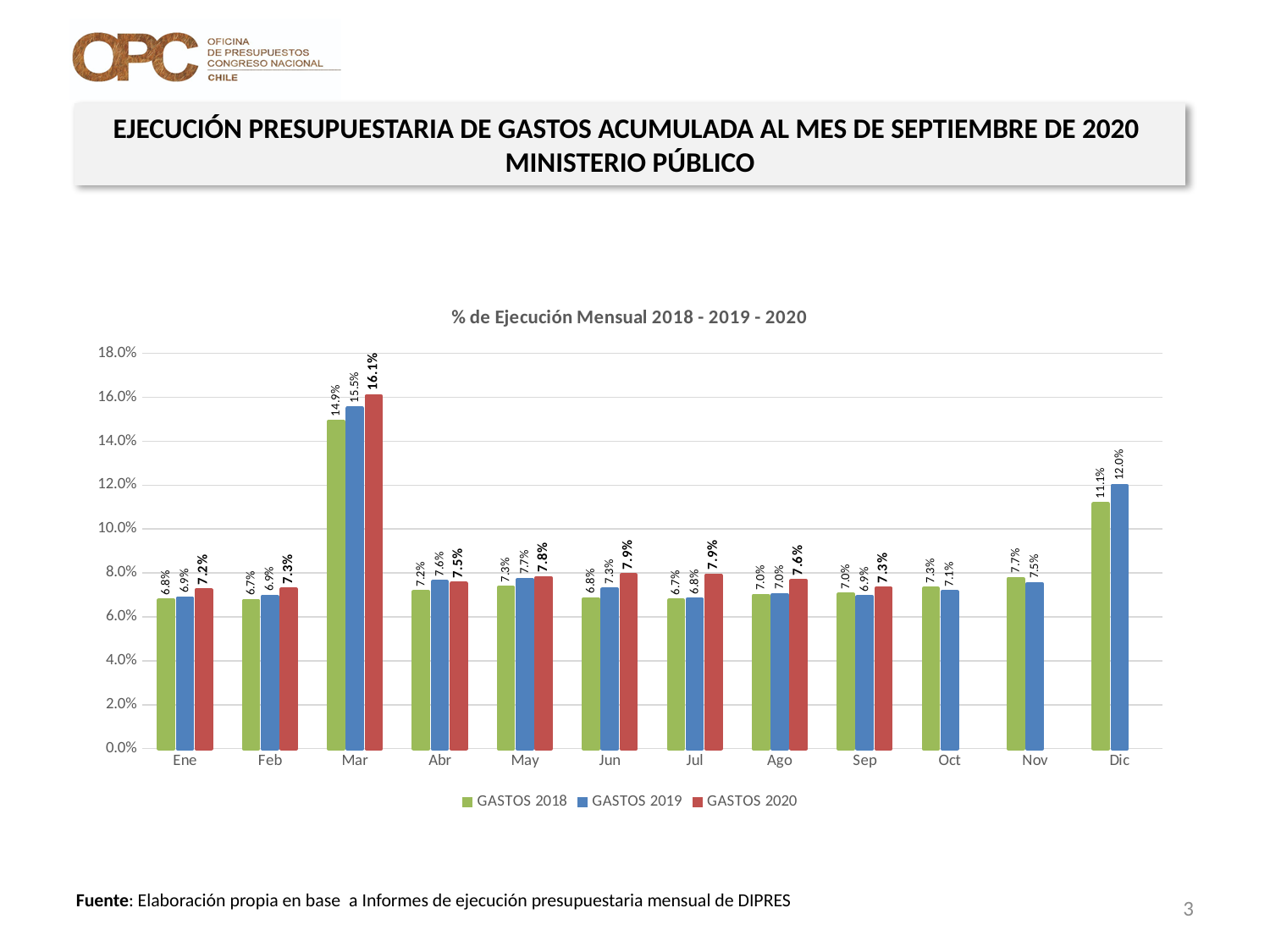
What kind of chart is shown on the slide? Bar chart What is the value for GASTOS 2020 in Mar? 16.1% How many months are shown on the x axis? 12 Which month has the highest value for GASTOS 2019? Mar Which is larger in Jul: GASTOS 2020 or GASTOS 2018? GASTOS 2020 What is the value for GASTOS 2020 in Sep? 7.3% Which month has the lowest value for GASTOS 2020? Ene How many series does the legend list? 3 What is the value for GASTOS 2018 in Dic? 11.1% Is the value for GASTOS 2019 in Dic greater or less than 10.0%? greater What is the value for GASTOS 2019 in Jun? 7.3% What is the difference between GASTOS 2020 and GASTOS 2018 in Mar? 1.2%